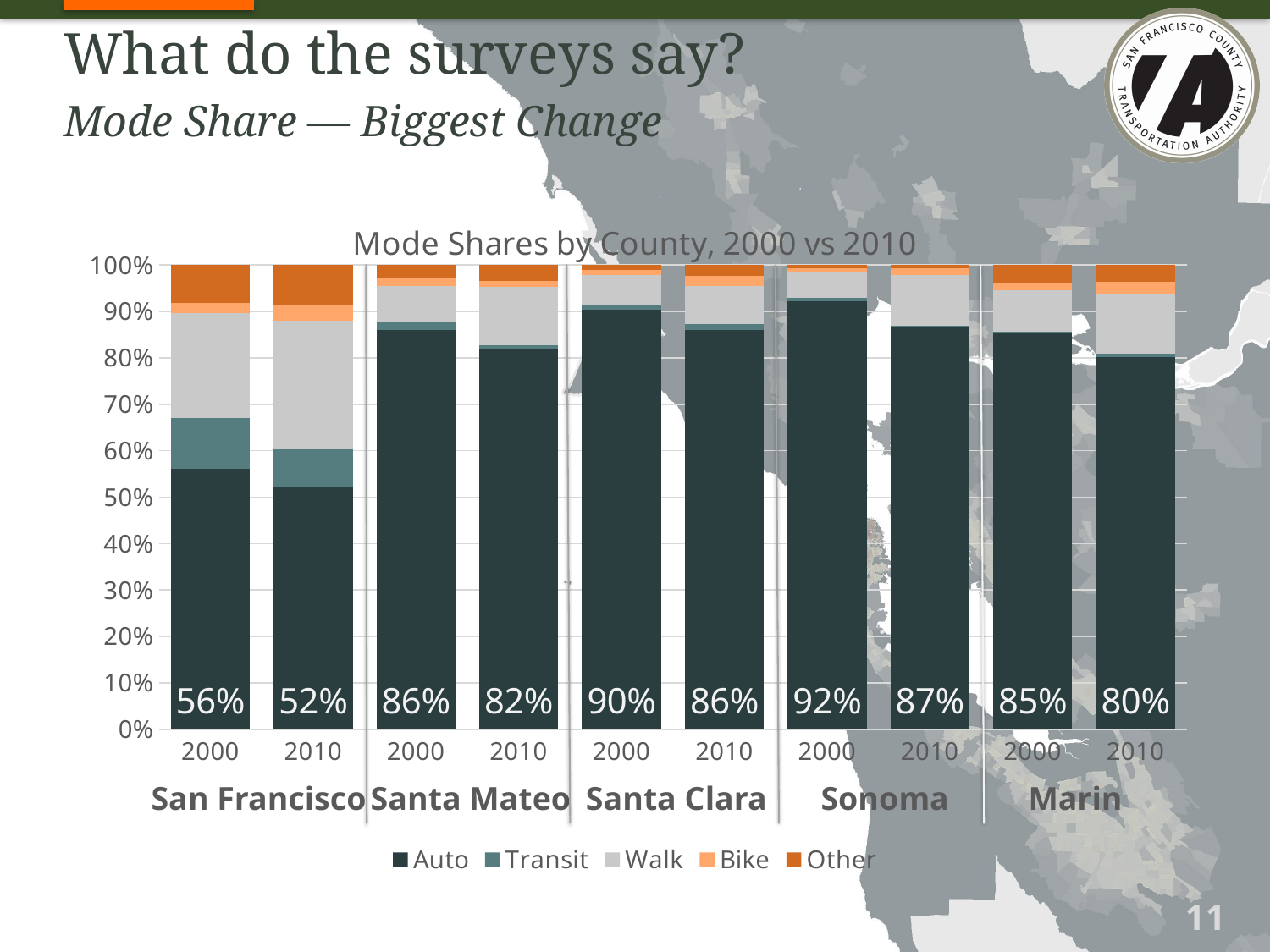
What is the title of the chart? Mode Shares by County, 2000 vs 2010 What is the Auto mode share for Marin in 2010? 80% How many counties are shown on the x axis? 5 Which county and year has the lowest Auto mode share? San Francisco, 2010 (52%) What is the Auto mode share for Sonoma in 2010? 87% Does the Auto mode share rise or fall from 2000 to 2010 in every county? Fall By how many percentage points did the Auto share in Santa Clara fall from 2000 to 2010? 4 percentage points Which has a larger Auto share: Santa Mateo in 2010 or Marin in 2010? Santa Mateo in 2010 How many series does the legend list? 5 What kind of chart is shown? Stacked bar chart What is the Auto mode share for San Francisco in 2000? 56% Which county and year has the highest Auto mode share? Sonoma, 2000 (92%)